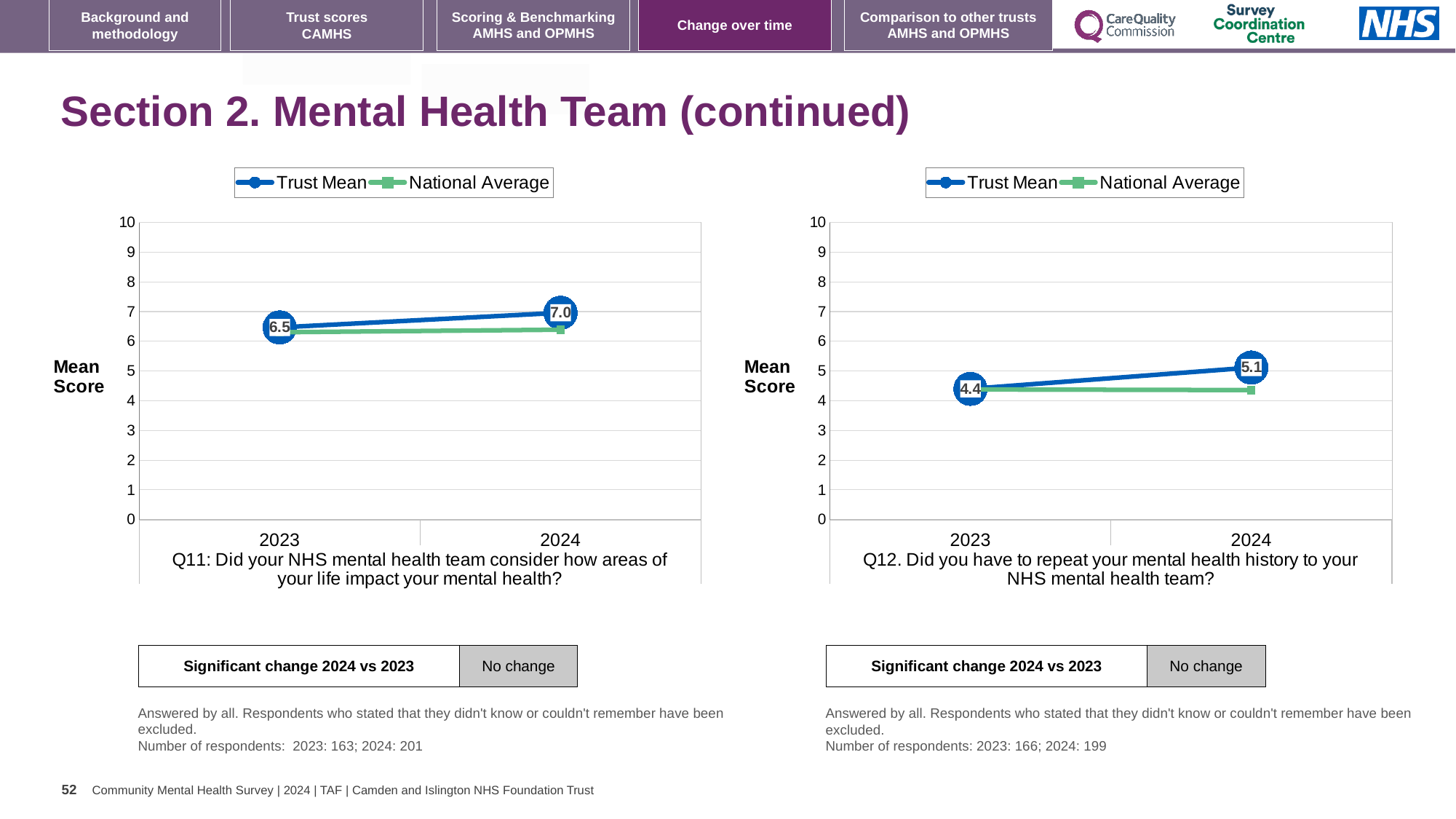
In the Q11 chart, by how much did the Trust Mean change from 2023 to 2024? 0.5 In the Q11 chart, is the National Average value for 2024 greater or less than 6? greater In the Q12 chart, what is the Trust Mean score for 2024? 5.1 In the Q12 chart, is the National Average value for 2024 greater or less than 5? less What type of chart is used for Q11? line chart In the Q12 chart, what is the difference between the Trust Mean in 2024 and in 2023? 0.7 In the Q11 chart, in 2024, which is higher: the Trust Mean or the National Average? Trust Mean In the Q12 chart, does the Trust Mean rise or fall from 2023 to 2024? rise How many series does the legend of the Q12 chart list? 2 In the Q11 chart, what is the Trust Mean score for 2023? 6.5 In the Q12 chart, what is the Trust Mean score for 2023? 4.4 In the Q11 chart, what is the Trust Mean score for 2024? 7.0